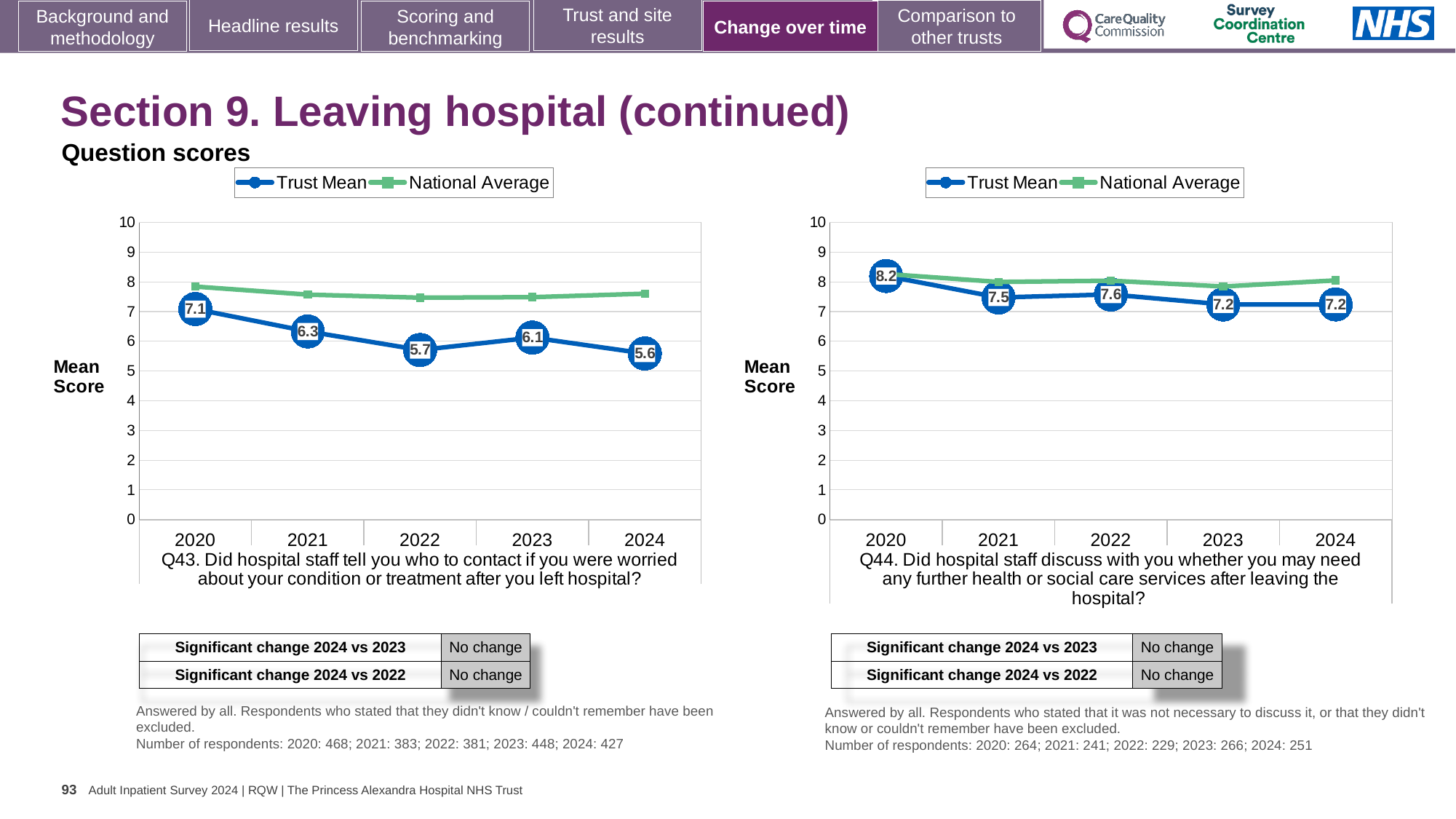
In the Q44 chart on the right, which year has the highest Trust Mean score? 2020 In the Q44 chart on the right, what is the Trust Mean score for 2023? 7.2 In the Q43 chart on the left, what is the difference between the Trust Mean scores for 2020 and 2024? 1.5 How many series does the legend of the Q43 chart on the left list? 2 What kind of chart is the Q43 chart on the left? Line chart In the Q43 chart on the left, what is the Trust Mean score for 2020? 7.1 In the Q44 chart on the right, what is the Trust Mean score for 2020? 8.2 In the Q43 chart on the left, which year has the lowest Trust Mean score? 2024 In the Q43 chart on the left, what is the Trust Mean score for 2024? 5.6 In the Q44 chart on the right, is the Trust Mean score for 2021 or 2022 larger? 2022 How many years are plotted on the x axis of the Q44 chart on the right? 5 In the Q43 chart on the left, is the National Average for 2020 greater or less than 7? greater